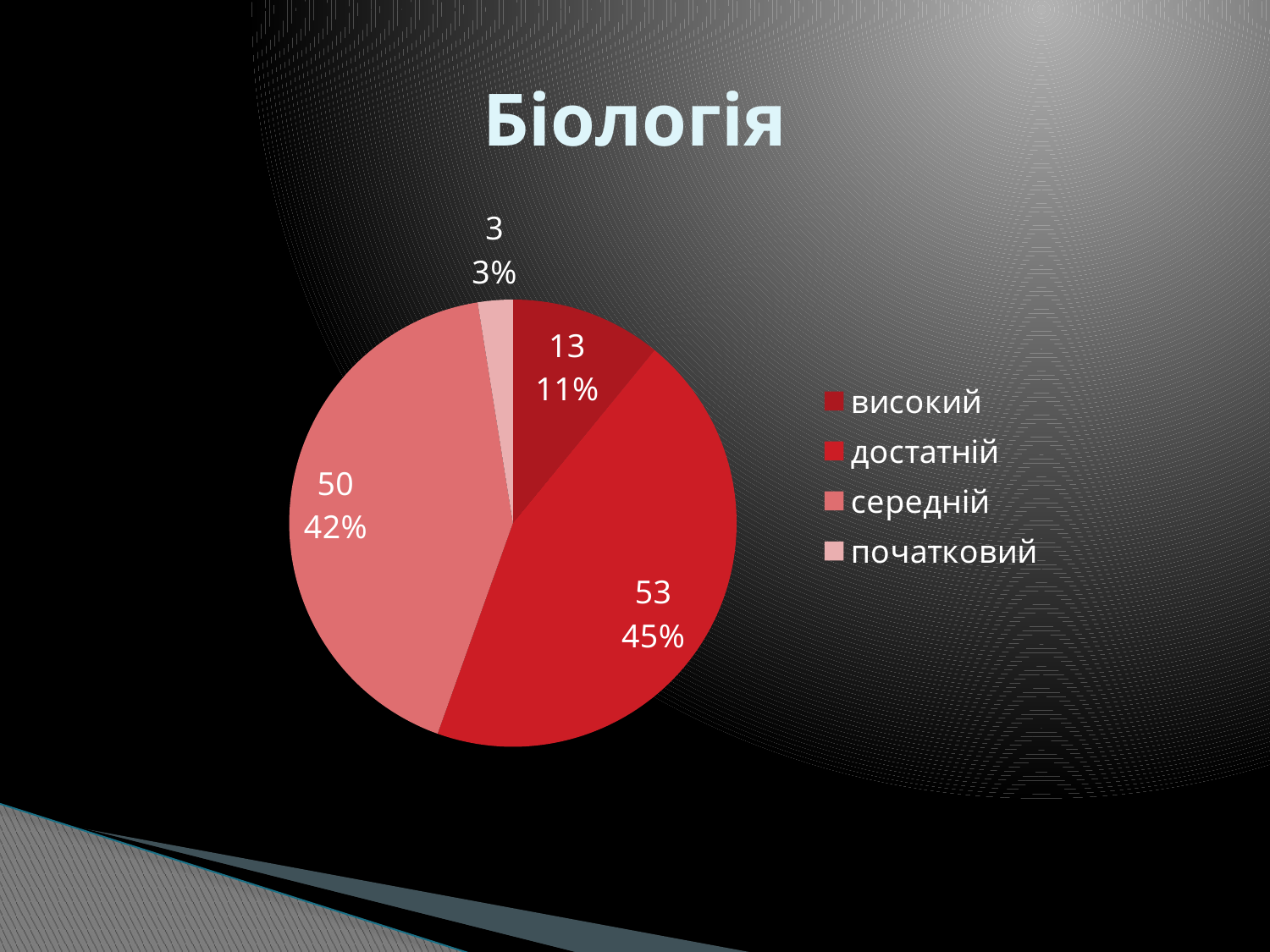
Which category has the smallest slice? початковий What is the value for достатній? 53 What is the value for середній? 50 What share of the pie does високий take? 11% What is the value for початковий? 3 What is the title of the chart? Біологія How many categories does the legend list? 4 Which category has the largest slice? достатній What is the difference between the values for достатній and середній? 3 What kind of chart is shown on the slide? pie chart What share of the pie does достатній take? 45% What is the value for високий? 13